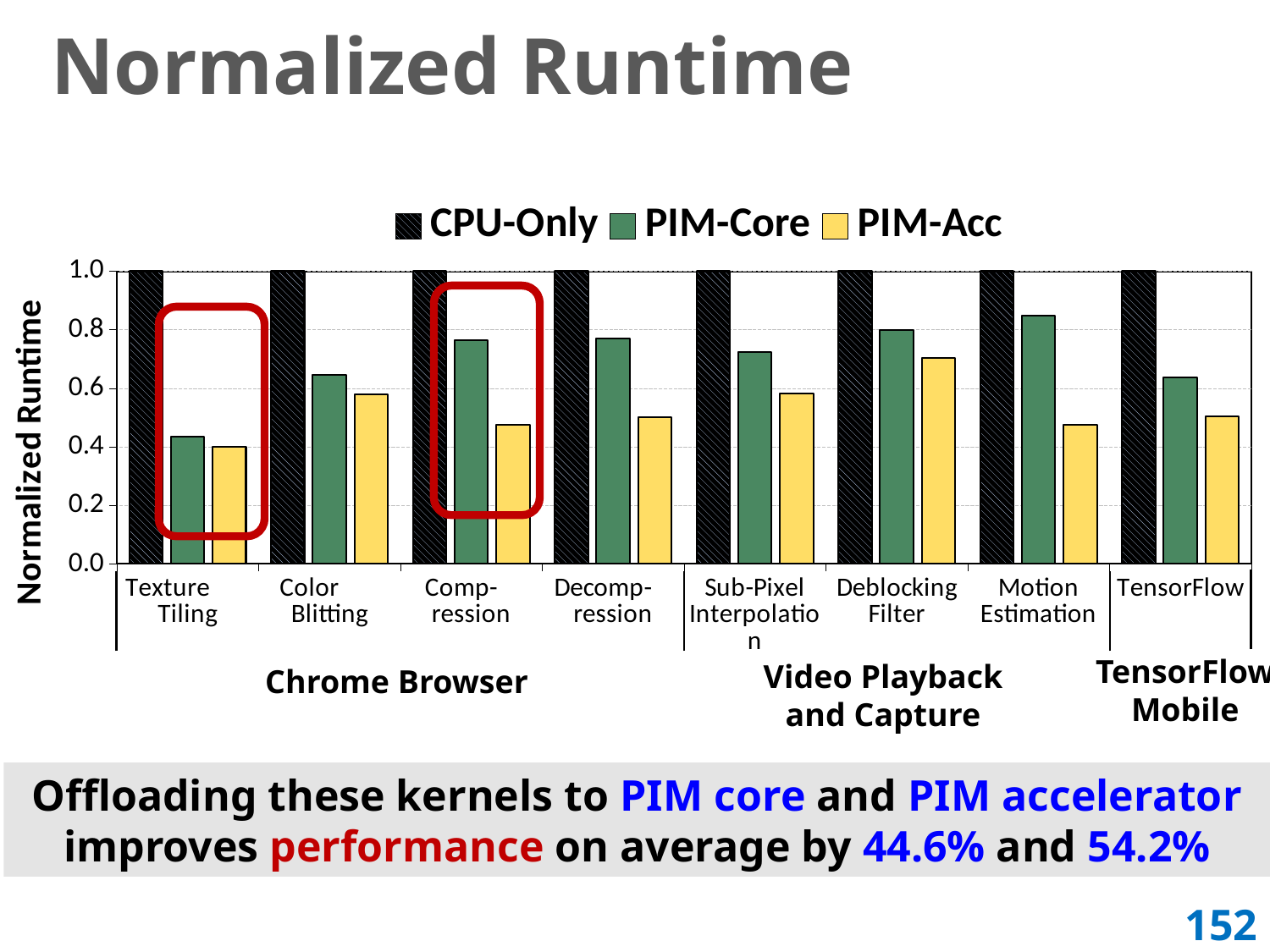
Which kernel has the lowest PIM-Core normalized runtime? Texture Tiling Is the PIM-Core value for Motion Estimation greater or less than 0.8? greater Is the PIM-Acc value for Texture Tiling greater or less than 0.6? less Which kernel has the lowest PIM-Acc normalized runtime? Texture Tiling What is the label on the y axis? Normalized Runtime Which kernel has the highest PIM-Core normalized runtime? Motion Estimation Is the PIM-Core value for Color Blitting greater or less than 0.6? greater How many kernel categories are plotted along the x axis? 8 For Compression, which is larger: the PIM-Core value or the PIM-Acc value? PIM-Core What is the normalized runtime for CPU-Only on Texture Tiling? 1.0 How many series does the legend list? 3 What kind of chart is shown on the slide? bar chart